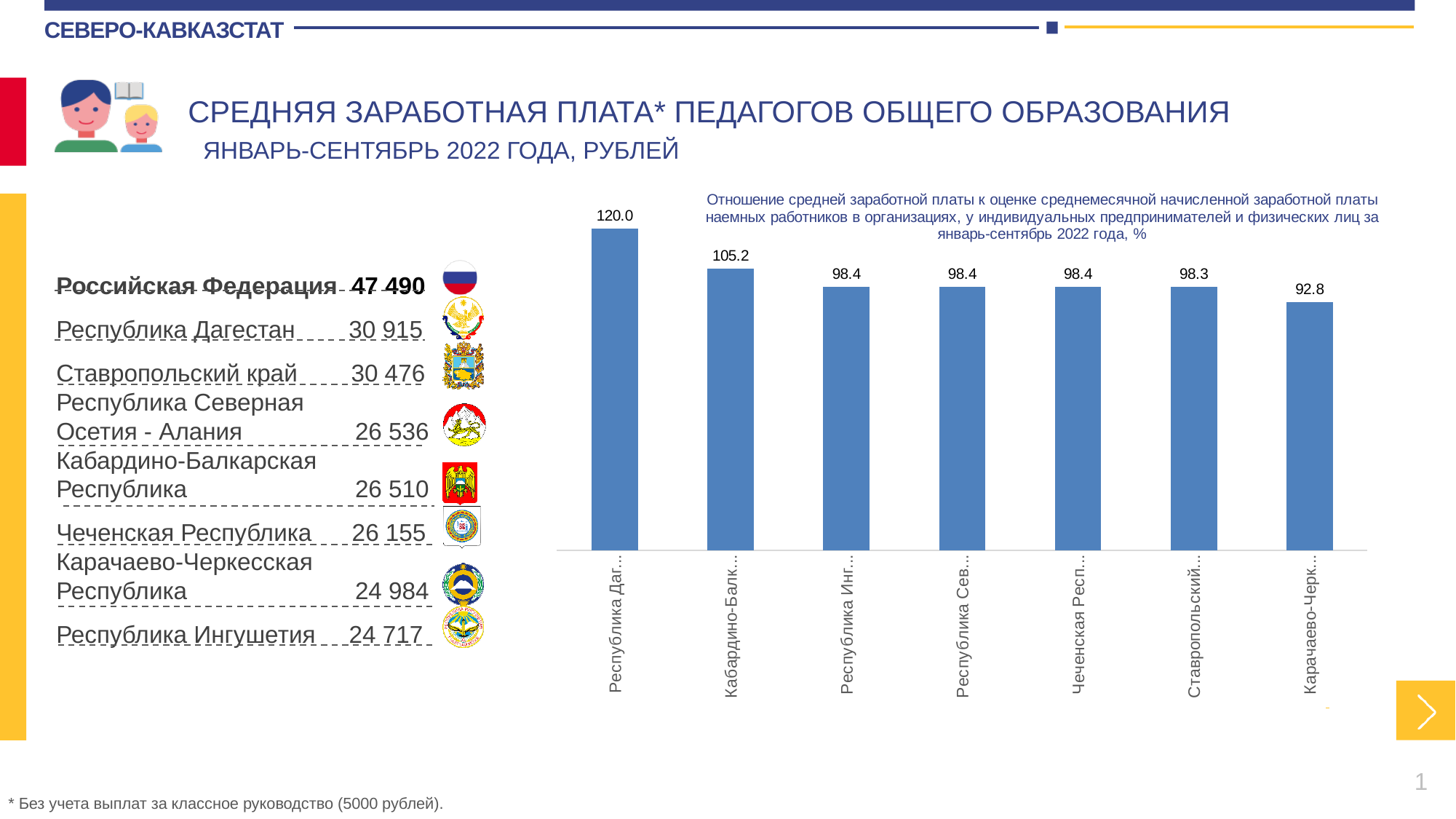
What is the difference between the values for "Республика Даг..." and "Кабардино-Балк..."? 14.8 Which category has the highest bar in the chart? Республика Даг... What is the value shown for the bar labelled "Республика Даг..."? 120.0 What is the difference between the values for "Республика Даг..." and "Карачаево-Черк..."? 27.2 How many bars are plotted in the chart? 7 What is the value shown for the bar labelled "Кабардино-Балк..."? 105.2 Which is larger, the value for "Кабардино-Балк..." or the value for "Ставропольский..."? Кабардино-Балк... Do the bar values rise or fall from left to right across the chart? Fall Which category has the lowest bar in the chart? Карачаево-Черк... What is the value shown for the bar labelled "Карачаево-Черк..."? 92.8 What kind of chart is shown on the slide? Bar chart What is the value shown for the bar labelled "Ставропольский..."? 98.3